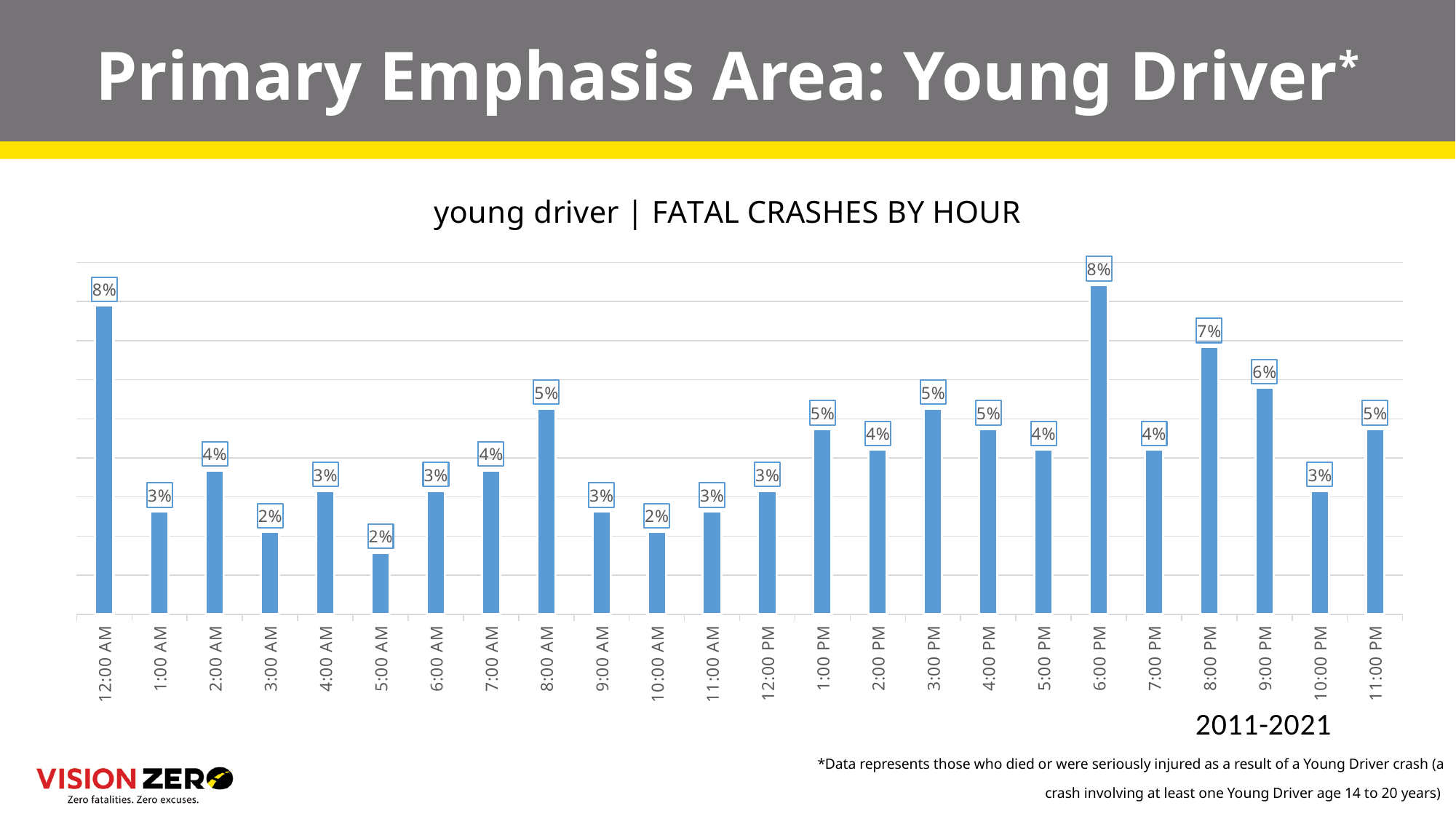
What is the value for 5:00 AM? 2% What is the value for 9:00 PM? 6% How many hour categories are shown on the x axis? 24 Which has the larger value, 6:00 PM or 9:00 PM? 6:00 PM What is the difference between the values for 6:00 PM and 7:00 PM? 4% Which has the larger value, 8:00 PM or 10:00 PM? 8:00 PM What is the value for 8:00 PM? 7% What is the value for 3:00 PM? 5% What is the value for 12:00 AM? 8% What is the difference between the values for 8:00 PM and 9:00 PM? 1% What kind of chart is shown on the slide? Bar chart What is the value for 7:00 PM? 4%